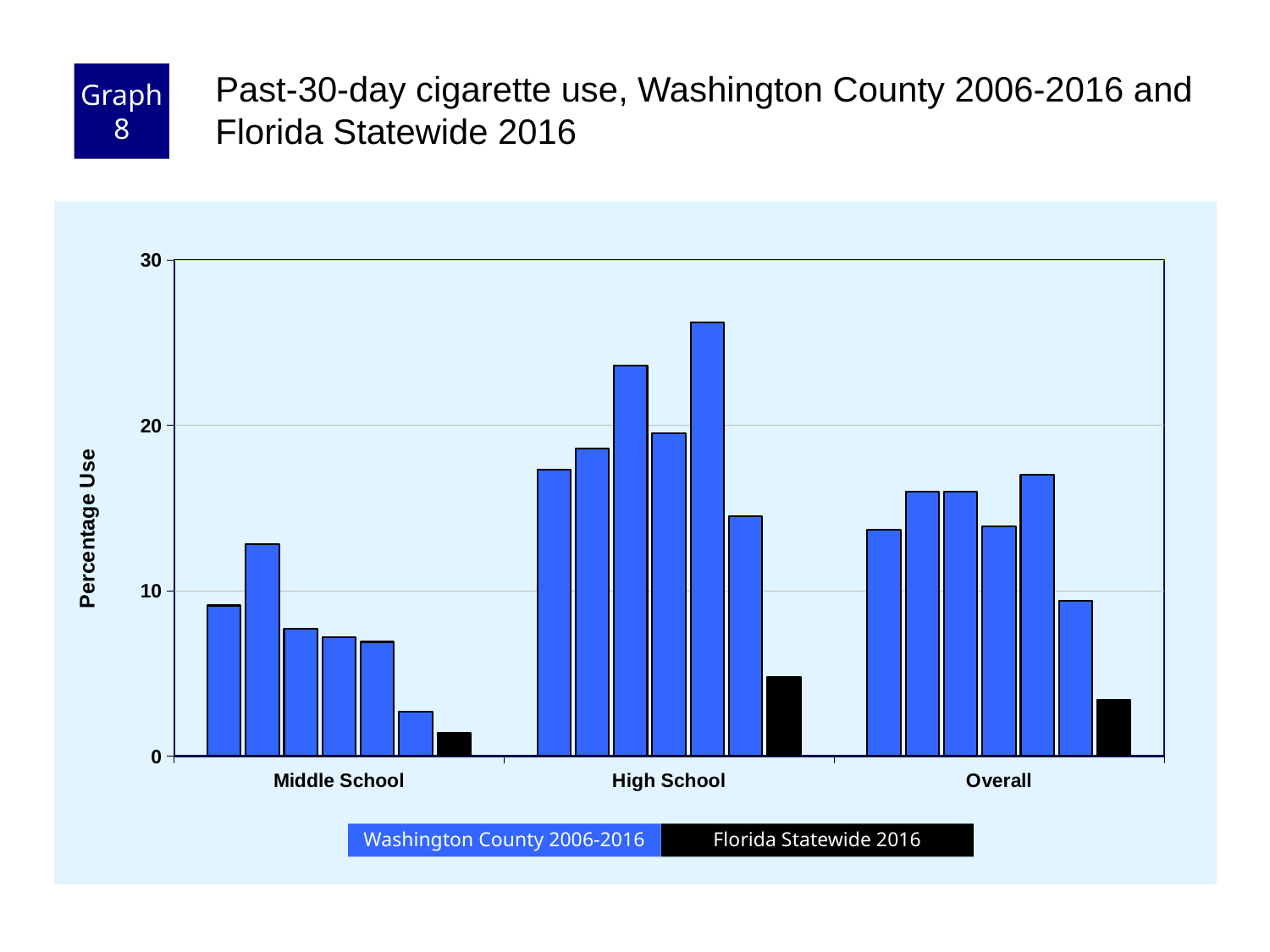
Is the second Washington County bar in the Middle School group greater or less than 10? greater Is the tallest Washington County bar in the High School group greater or less than 20? greater What kind of chart is shown on the slide? bar chart In the Middle School group, is the last Washington County bar higher or lower than the first Washington County bar? lower Which category group contains the shortest bar on the chart? Middle School Which category group contains the tallest bar on the chart? High School Is the Florida Statewide 2016 value for High School greater or less than 10? less What is the label on the y axis? Percentage Use How many series does the legend list? 2 How many category groups are shown along the x axis? 3 Which is larger: the Florida Statewide 2016 value for High School or for Middle School? High School Which colour represents Florida Statewide 2016 in the legend? black